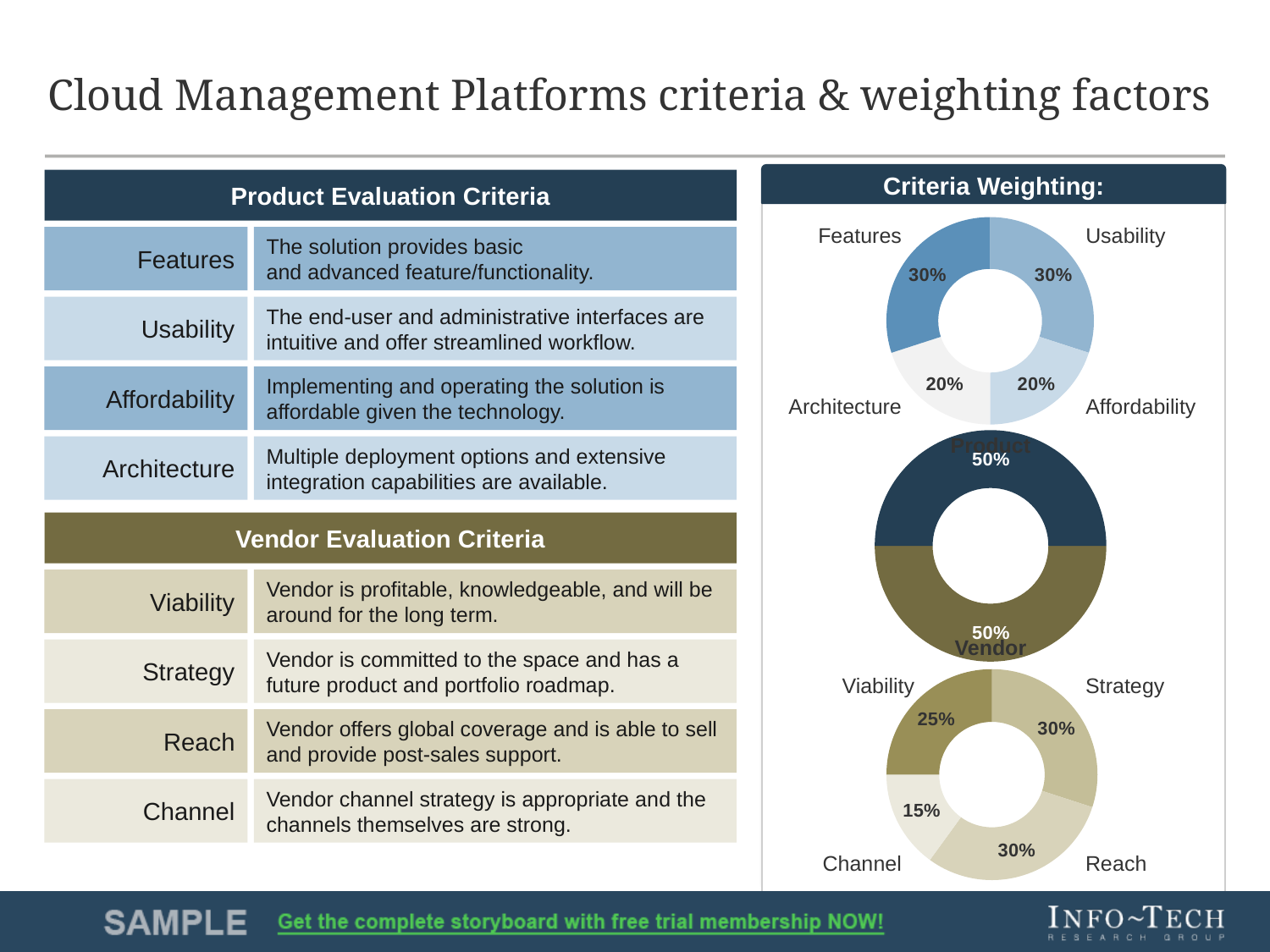
In the bottom donut chart, what is the weighting for Channel? 15% In the top donut chart, which is larger, the weighting for Usability or for Architecture? Usability In the bottom donut chart, what is the difference between the weightings for Strategy and Channel? 15% In the top donut chart, what is the weighting for Features? 30% In the top donut chart, what is the weighting for Affordability? 20% What kind of chart is used to show the criteria weighting? Donut chart In the bottom donut chart, what is the weighting for Viability? 25% How many segments does the top donut chart have? 4 How many segments does the middle donut chart have? 2 In the middle donut chart, what is the weighting for Vendor? 50% What is the title above the charts on the right side of the slide? Criteria Weighting: In the bottom donut chart, which criterion has the lowest weighting? Channel